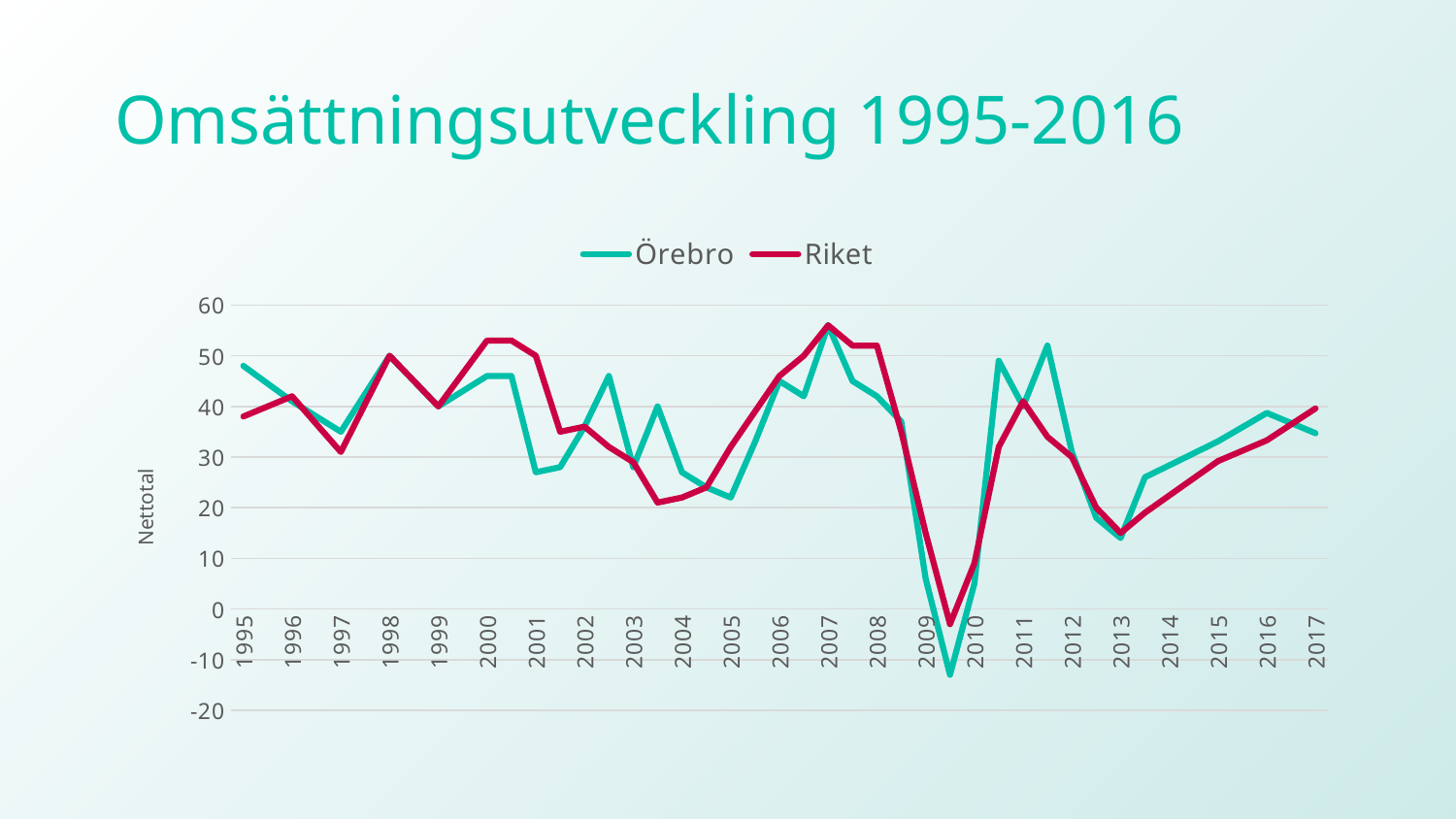
Is the lowest value of the Örebro line greater or less than 0? less Which series reaches the lowest value anywhere on the chart? Örebro What kind of chart is shown on the slide? line chart Is the value for Riket in 1995 greater or less than 40? less How many series does the legend list? 2 What is the title of the chart? Omsättningsutveckling 1995-2016 Is the value for Örebro in 1995 greater or less than 40? greater In 1995, which series has the higher value, Örebro or Riket? Örebro What is the label on the vertical axis? Nettotal In 2000, which series has the higher value, Örebro or Riket? Riket How many year labels are shown on the x axis? 23